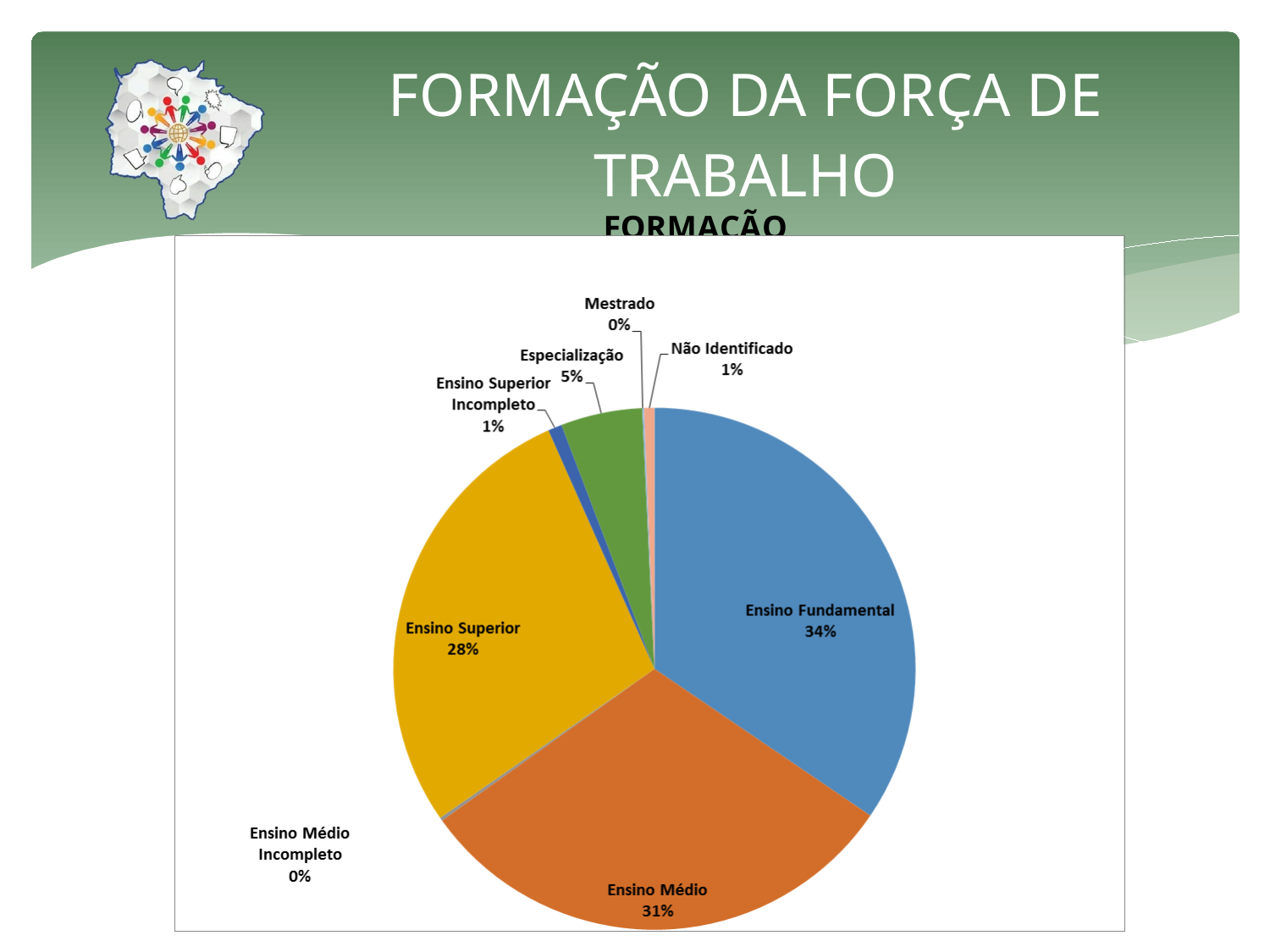
What kind of chart is shown on the slide? Pie chart What is the difference in percentage points between Ensino Fundamental and Ensino Superior? 6 What is the value shown for Ensino Médio? 31% What share of the pie does Ensino Fundamental represent? 34% What is the value shown for Especialização? 5% What is the value shown for Mestrado? 0% Which is larger, Ensino Médio or Ensino Superior? Ensino Médio What is the difference in percentage points between Especialização and Não Identificado? 4 How many categories are labelled on the pie chart? 8 What colour is the Ensino Superior slice? Yellow What is the value shown for Ensino Superior? 28% Which category has the largest slice of the pie? Ensino Fundamental